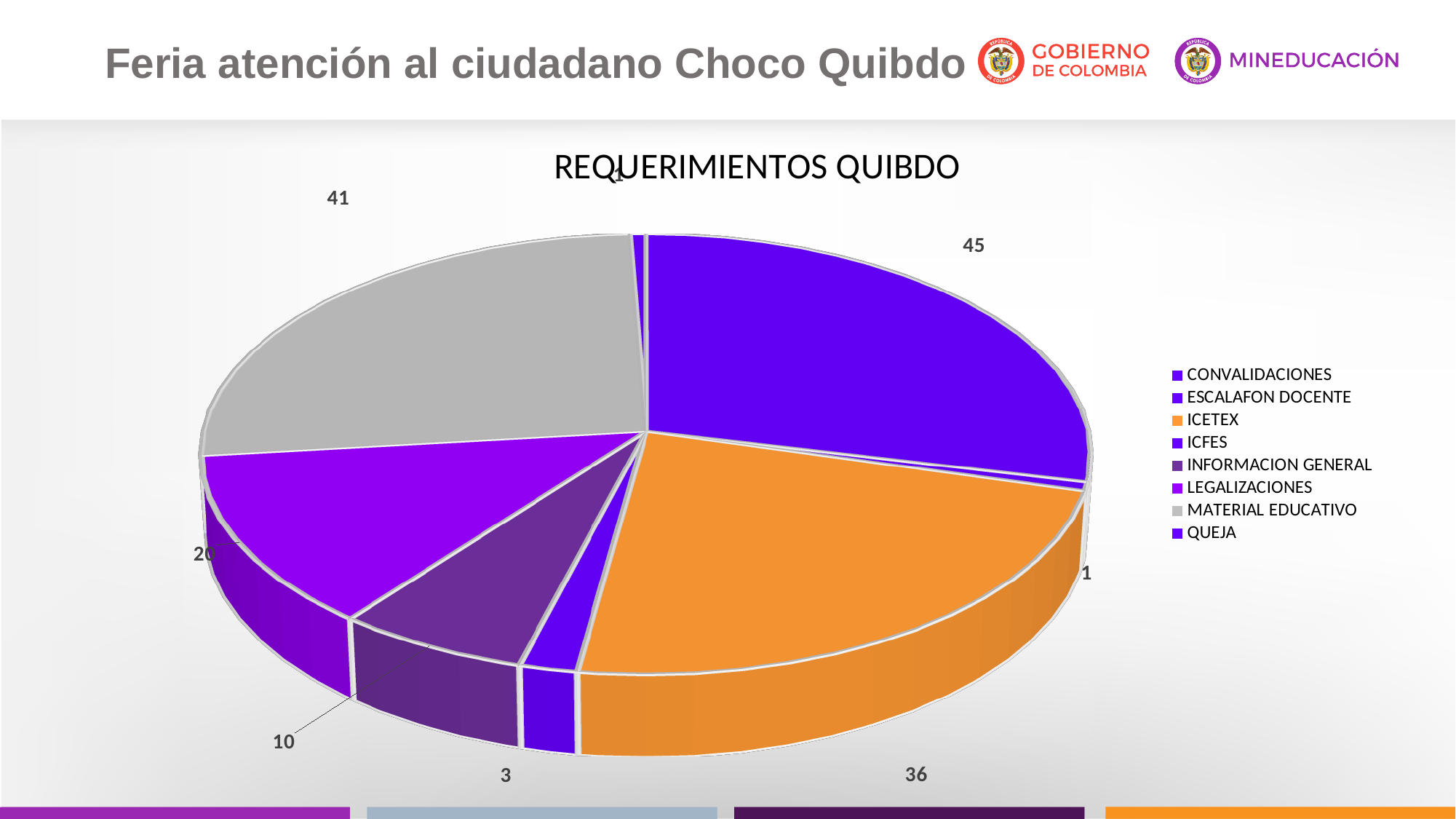
What is the value for LEGALIZACIONES? 20 What is the value for MATERIAL EDUCATIVO? 41 What is the value for ICETEX? 36 What type of chart is shown on the slide? pie chart Which is larger, the value for MATERIAL EDUCATIVO or the value for ICETEX? MATERIAL EDUCATIVO What is the value for INFORMACION GENERAL? 10 What is the value for CONVALIDACIONES? 45 What is the difference between the values for CONVALIDACIONES and ICETEX? 9 What is the title of the chart? REQUERIMIENTOS QUIBDO What is the difference between the values for LEGALIZACIONES and INFORMACION GENERAL? 10 How many categories does the legend list? 8 Which category has the largest slice of the pie? CONVALIDACIONES